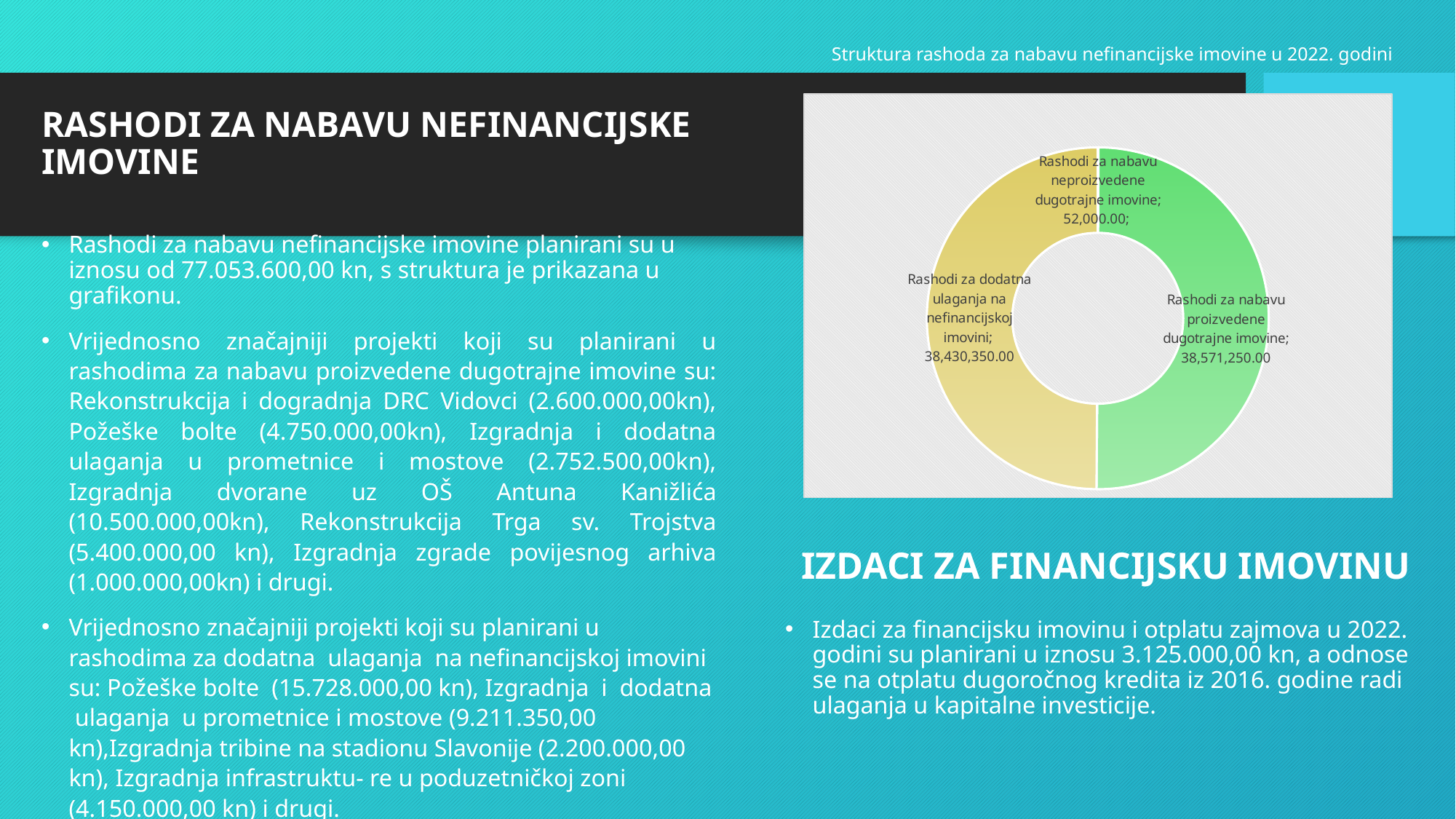
How many categories does the chart show? 3 What type of chart is shown on the slide? doughnut chart What colour is the slice for Rashodi za dodatna ulaganja na nefinancijskoj imovini? yellow What is the difference between the values for Rashodi za nabavu proizvedene dugotrajne imovine and Rashodi za dodatna ulaganja na nefinancijskoj imovini? 140,900.00 What is the title of the chart? Struktura rashoda za nabavu nefinancijske imovine u 2022. godini Which category has the smallest value? Rashodi za nabavu neproizvedene dugotrajne imovine What is the value for Rashodi za nabavu proizvedene dugotrajne imovine? 38,571,250.00 What is the value for Rashodi za dodatna ulaganja na nefinancijskoj imovini? 38,430,350.00 What is the total of all three categories in the chart? 77,053,600.00 Which category has the largest value? Rashodi za nabavu proizvedene dugotrajne imovine What is the value for Rashodi za nabavu neproizvedene dugotrajne imovine? 52,000.00 Which is larger: the value for Rashodi za nabavu proizvedene dugotrajne imovine or the value for Rashodi za nabavu neproizvedene dugotrajne imovine? Rashodi za nabavu proizvedene dugotrajne imovine